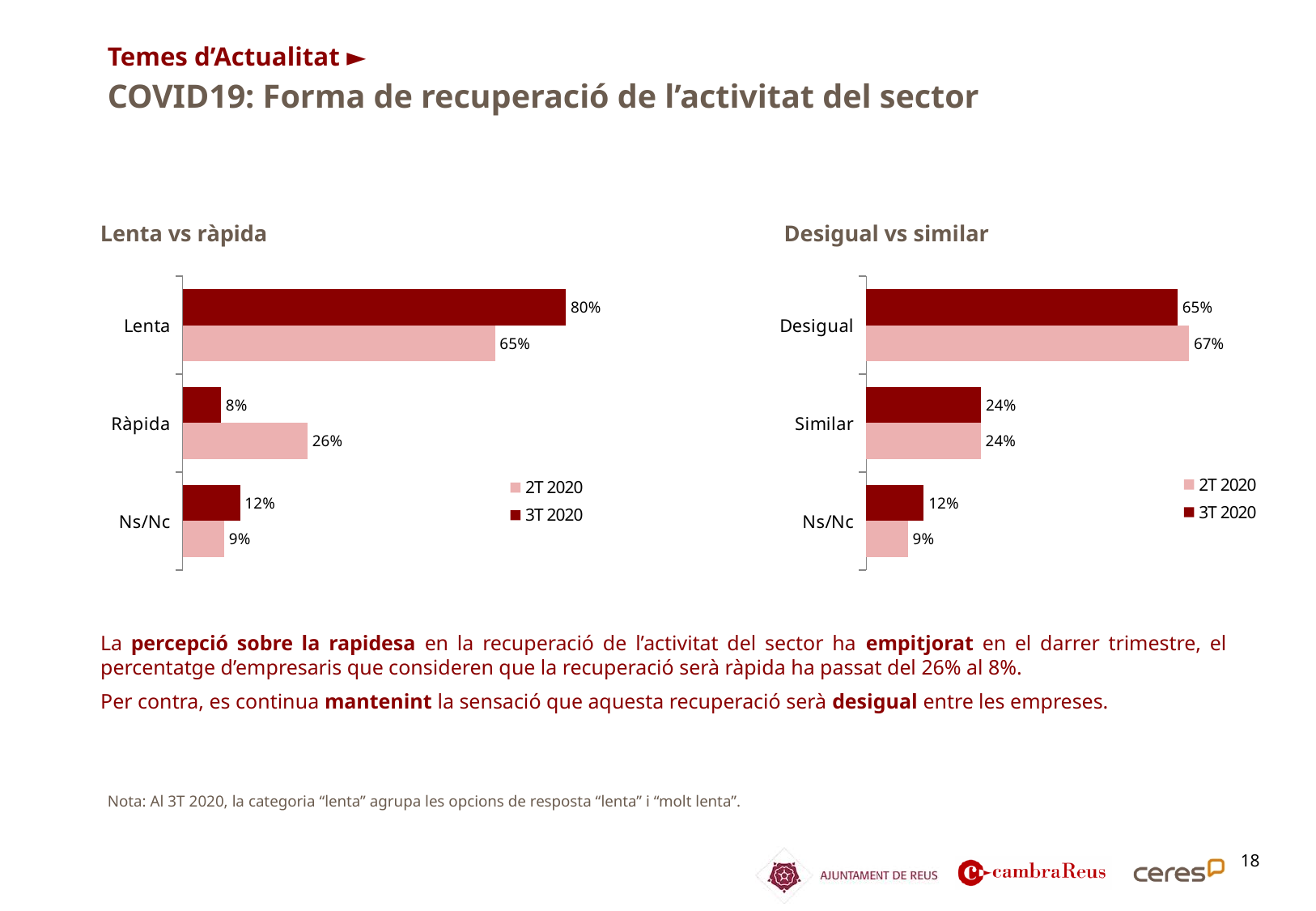
In the 'Lenta vs ràpida' chart, what is the value for Ràpida in 2T 2020? 26% In the 'Desigual vs similar' chart, what is the value for Similar in 3T 2020? 24% How many categories does the 'Lenta vs ràpida' chart show? 3 In the 'Desigual vs similar' chart, which is larger for Desigual: the 2T 2020 value or the 3T 2020 value? 2T 2020 How many series does the legend of the 'Desigual vs similar' chart list? 2 In the 'Lenta vs ràpida' chart, what is the difference between the 2T 2020 and 3T 2020 values for Ràpida? 18% In the 'Lenta vs ràpida' chart, what is the difference between the 3T 2020 and 2T 2020 values for Lenta? 15% What kind of chart is the 'Desigual vs similar' chart? Bar chart In the 'Desigual vs similar' chart, which category has the highest value for 2T 2020? Desigual In the 'Lenta vs ràpida' chart, which category has the lowest value for 3T 2020? Ràpida In the 'Desigual vs similar' chart, what is the value for Desigual in 2T 2020? 67% In the 'Lenta vs ràpida' chart, what is the value for Lenta in 3T 2020? 80%